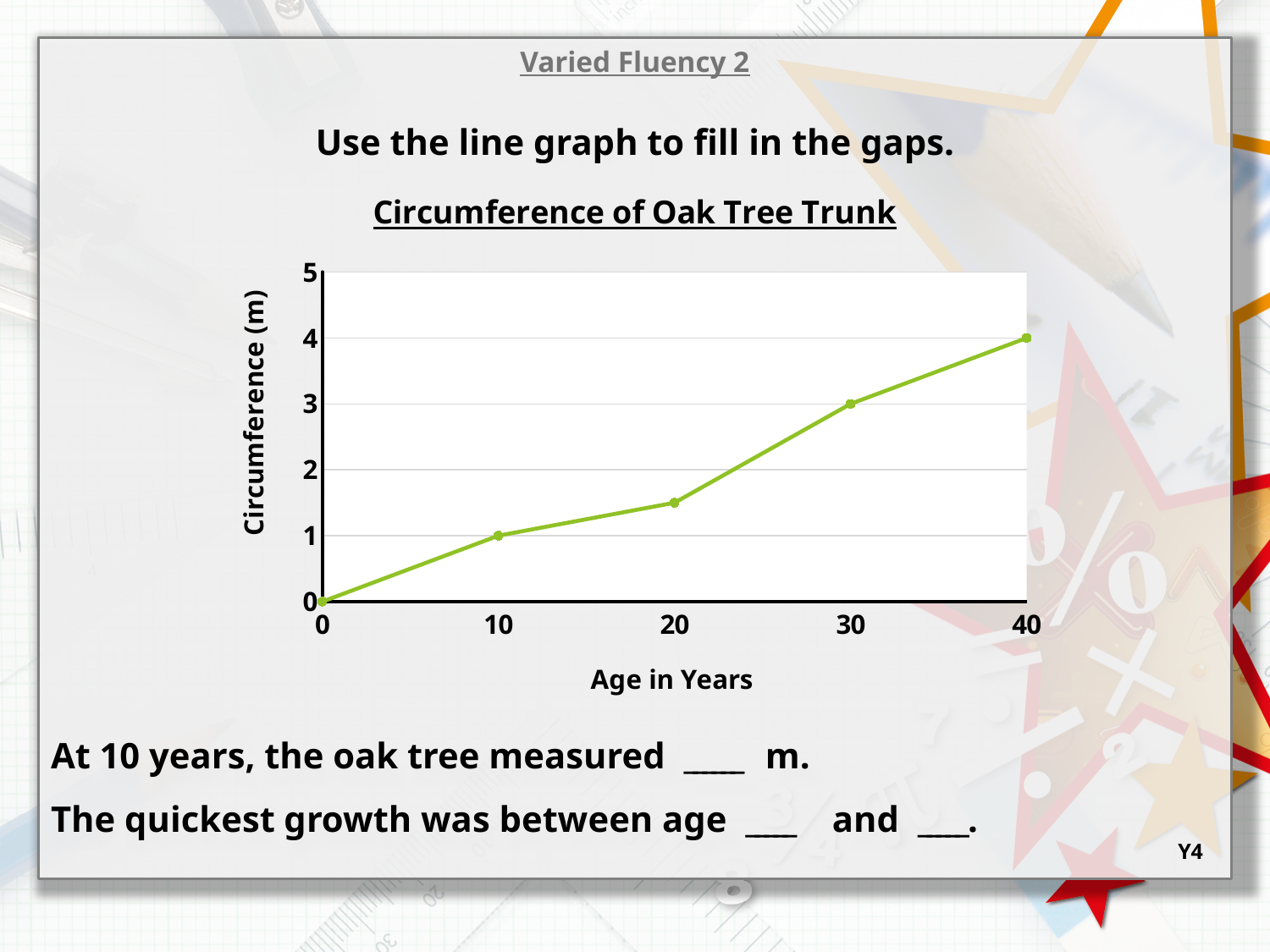
What is the title of the x axis? Age in Years At which age is the circumference of the oak tree trunk lowest? 0 At which age is the circumference of the oak tree trunk highest? 40 Is the circumference at 20 years greater or less than 2? less Does the circumference rise or fall as age increases? rise What is the circumference of the oak tree trunk at 30 years? 3 What is the difference in circumference between age 40 and age 10? 3 What is the circumference of the oak tree trunk at 40 years? 4 What is the circumference of the oak tree trunk at 10 years? 1 What kind of chart is shown on the slide? line chart Which has the larger circumference, age 30 or age 10? 30 How many data points are plotted on the line graph? 5